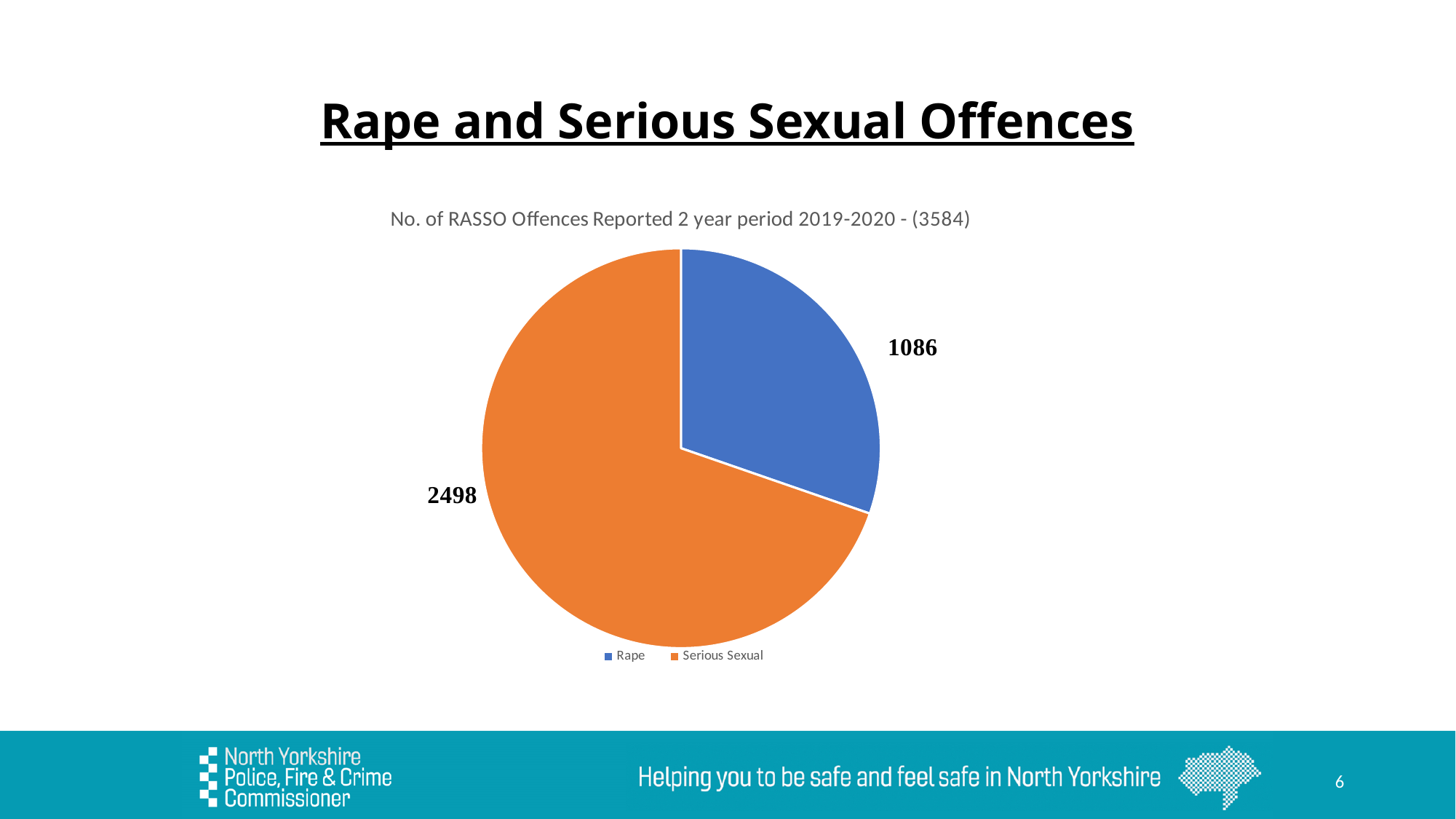
Which category has the smallest slice? Rape Which is larger, the value for Rape or the value for Serious Sexual? Serious Sexual How many categories does the pie chart show? 2 What kind of chart is shown on the slide? pie chart What is the difference between the Serious Sexual and Rape values? 1412 What is the total of the two slices? 3584 What is the value for Rape? 1086 Which category has the largest slice? Serious Sexual What colour is the Serious Sexual slice? orange What is the value for Serious Sexual? 2498 What is the title of the chart? No. of RASSO Offences Reported 2 year period 2019-2020 - (3584)